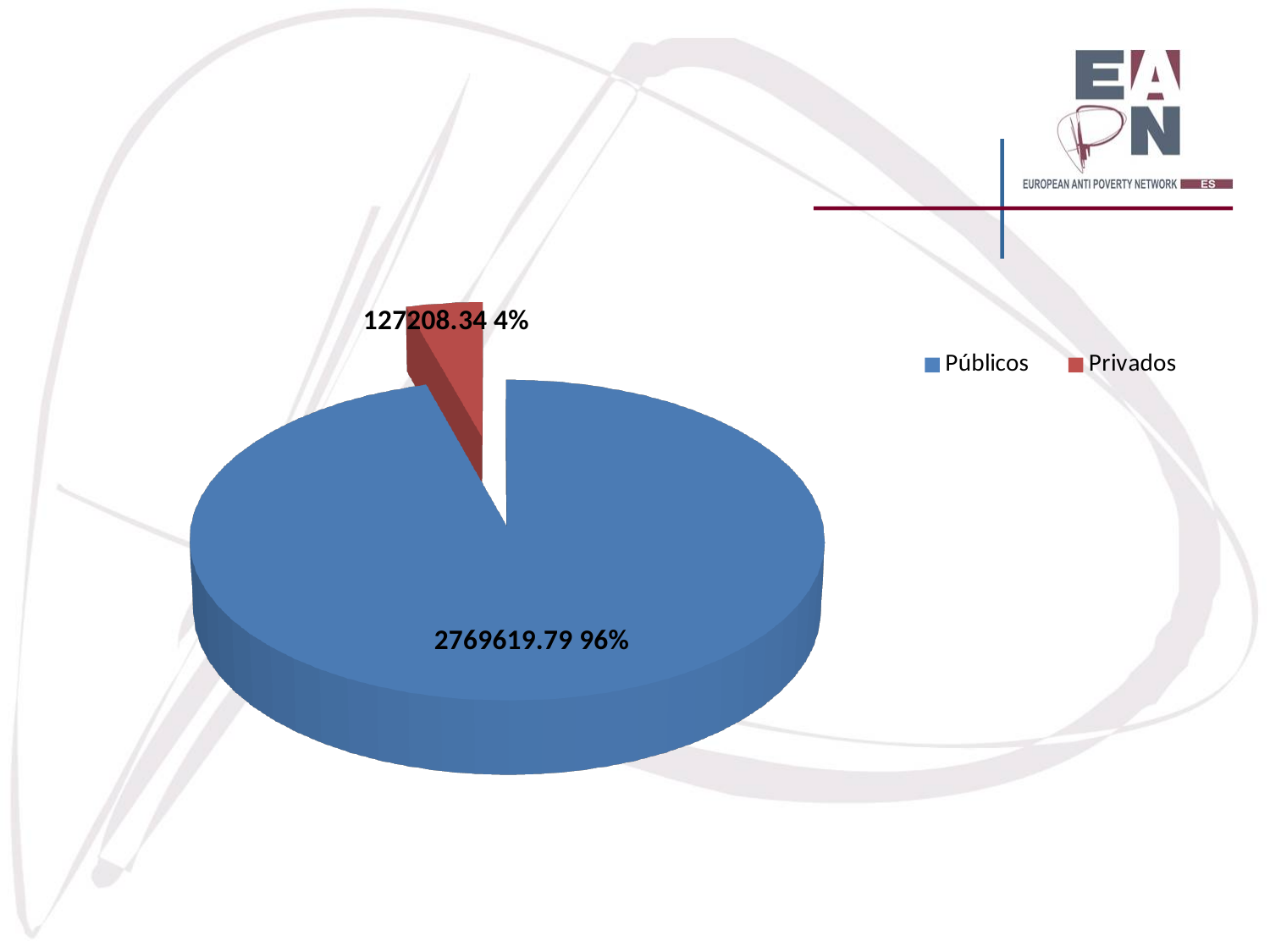
Which category has the smallest slice? Privados What is the value for Privados? 127208.34 Which category has the largest slice? Públicos What kind of chart is shown on the slide? Pie chart What share of the pie does Privados represent? 4% What is the difference between the values for Públicos and Privados? 2642411.45 What share of the pie does Públicos represent? 96% How many categories does the pie chart have? 2 What is the value for Públicos? 2769619.79 What is the total of the two slices? 2896828.13 What colour is the Privados slice? Red Which is larger, Públicos or Privados? Públicos